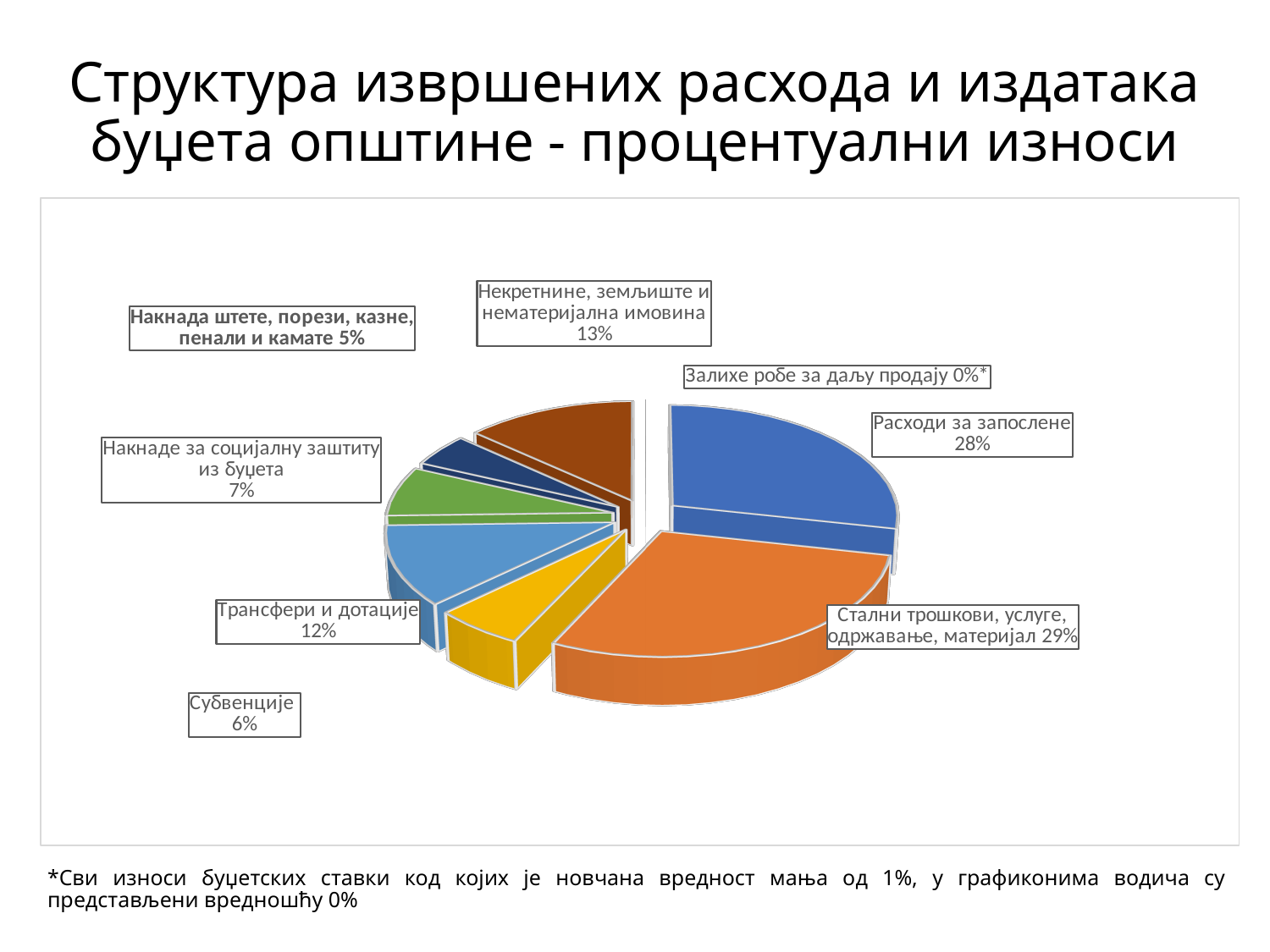
Which category has the largest share of the pie? Стални трошкови, услуге, одржавање, материјал Which category has the smallest share of the pie? Залихе робе за даљу продају What kind of chart is shown on the slide? pie chart Which is larger: the share for Трансфери и дотације or the share for Накнада штете, порези, казне, пенали и камате? Трансфери и дотације What is the difference in percentage points between Некретнине, земљиште и нематеријална имовина and Накнаде за социјалну заштиту из буџета? 6 What percentage share is shown for Стални трошкови, услуге, одржавање, материјал? 29% What percentage share is shown for Субвенције? 6% What percentage share is shown for Некретнине, земљиште и нематеријална имовина? 13% How many categories are shown in the pie chart? 8 What is the title of the slide containing the chart? Структура извршених расхода и издатака буџета општине - процентуални износи What percentage share is shown for Расходи за запослене? 28% What percentage share is shown for Трансфери и дотације? 12%